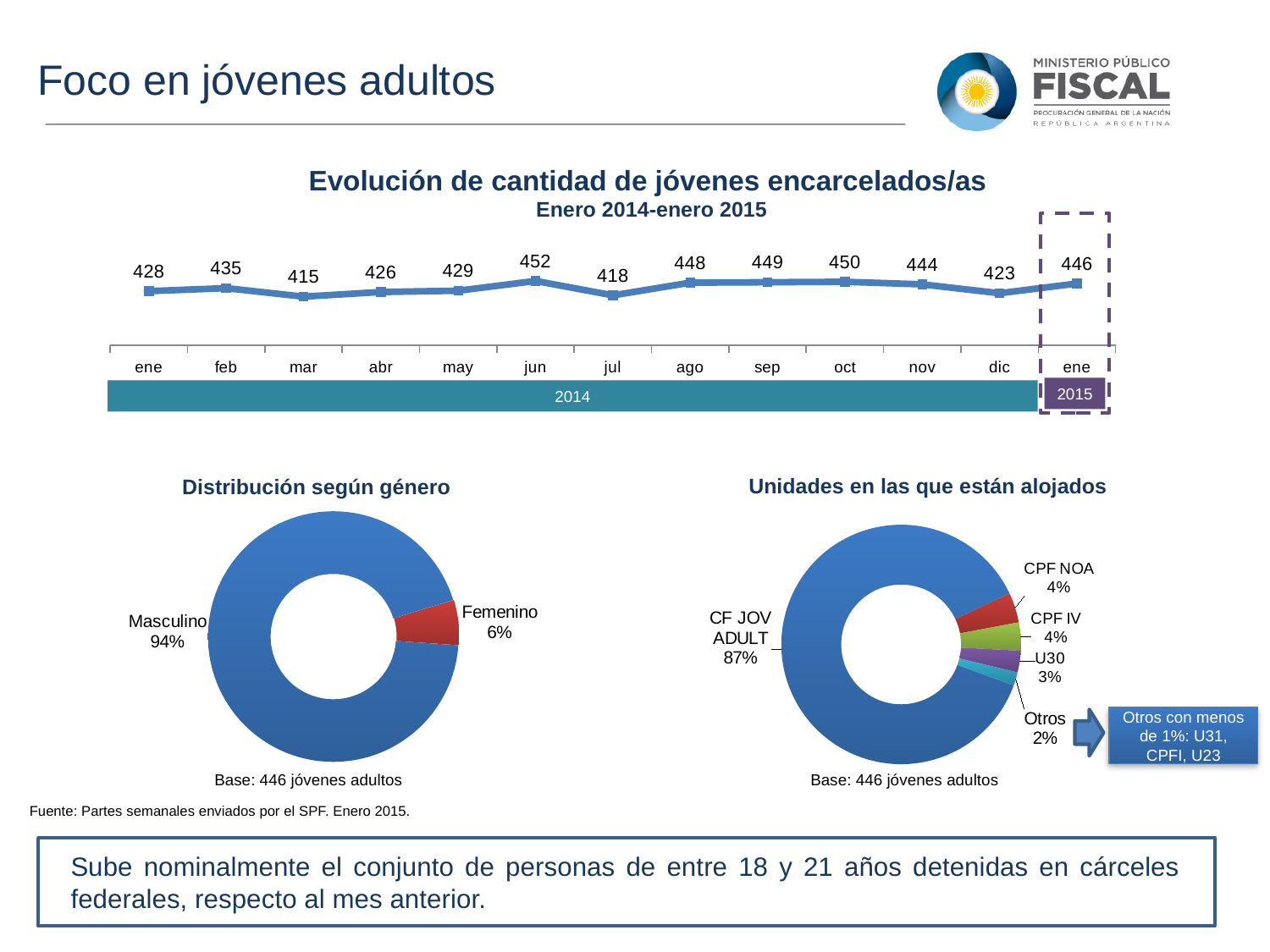
In the 'Distribución según género' chart, what share is Femenino? 6% In the 'Evolución de cantidad de jóvenes encarcelados/as' chart, what is the value for ene 2015? 446 In the 'Unidades en las que están alojados' chart, what is the difference between the shares of CPF NOA and Otros? 2% In the 'Evolución de cantidad de jóvenes encarcelados/as' chart, what is the value for jun 2014? 452 In the 'Evolución de cantidad de jóvenes encarcelados/as' chart, what is the difference between the values for ene 2015 and dic 2014? 23 In the 'Distribución según género' chart, which category has the largest share? Masculino In the 'Evolución de cantidad de jóvenes encarcelados/as' chart, which is larger, the value for feb or the value for jul? feb What kind of chart is 'Evolución de cantidad de jóvenes encarcelados/as'? line chart In the 'Evolución de cantidad de jóvenes encarcelados/as' chart, which month has the highest value? jun In the 'Evolución de cantidad de jóvenes encarcelados/as' chart, which month has the lowest value? mar How many data points are plotted in the 'Evolución de cantidad de jóvenes encarcelados/as' chart? 13 In the 'Unidades en las que están alojados' chart, what share is CF JOV ADULT? 87%